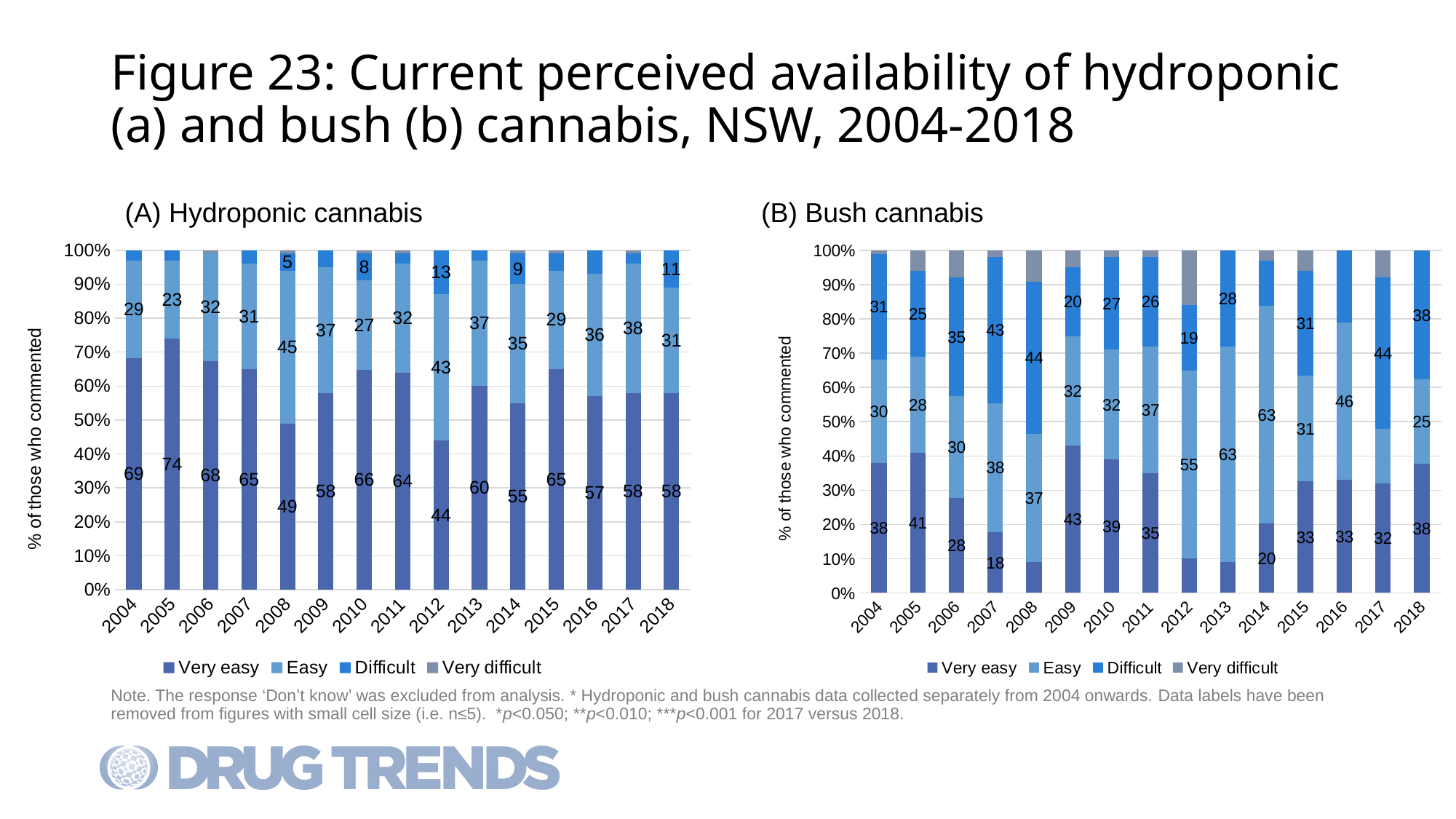
What kind of chart is the (B) Bush cannabis chart? Stacked bar chart In the (B) Bush cannabis chart, what is the difference between the 'Difficult' values for 2017 and 2018? 6 How many years are shown on the x axis of the (B) Bush cannabis chart? 15 In the (A) Hydroponic cannabis chart, which year has the lowest labelled 'Very easy' value? 2012 In the (A) Hydroponic cannabis chart, which is larger: the 'Easy' value for 2008 or for 2012? 2008 What is the y-axis label of the (A) Hydroponic cannabis chart? % of those who commented In the (A) Hydroponic cannabis chart, what percentage reported 'Very easy' in 2005? 74 In the (B) Bush cannabis chart, what is the 'Easy' value for 2013? 63 In the (A) Hydroponic cannabis chart, what is the 'Difficult' value labelled for 2018? 11 In the (A) Hydroponic cannabis chart, which year has the highest 'Very easy' value? 2005 In the (B) Bush cannabis chart, is the 'Very easy' value for 2008 greater or less than 20%? less How many series does the legend of the (A) Hydroponic cannabis chart list? 4